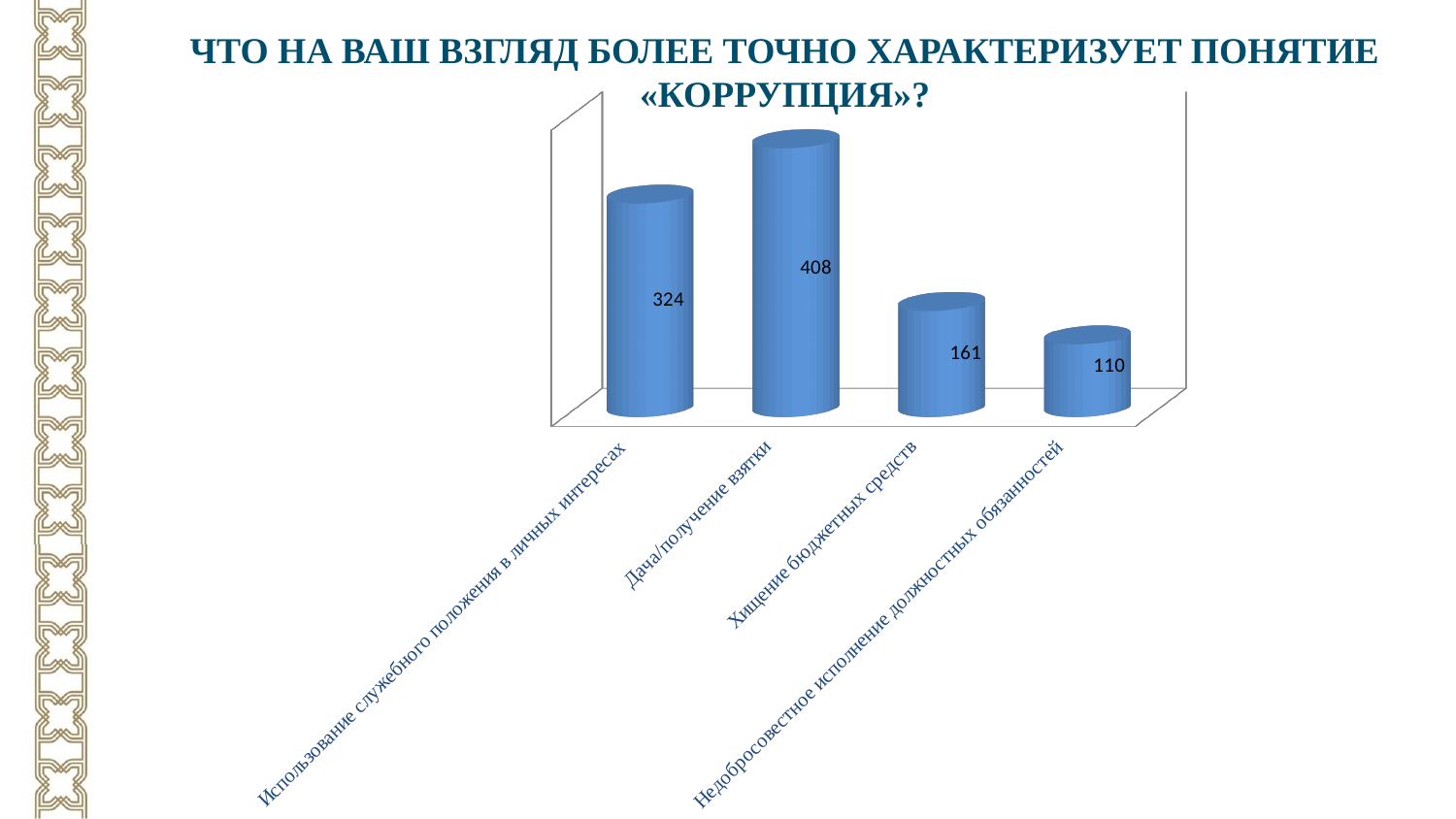
Which is larger: the value for «Использование служебного положения в личных интересах» or for «Хищение бюджетных средств»? Использование служебного положения в личных интересах What is the title of the chart? ЧТО НА ВАШ ВЗГЛЯД БОЛЕЕ ТОЧНО ХАРАКТЕРИЗУЕТ ПОНЯТИЕ «КОРРУПЦИЯ»? Which category has the highest value? Дача/получение взятки What is the value for «Недобросовестное исполнение должностных обязанностей»? 110 What is the value for «Использование служебного положения в личных интересах»? 324 What is the difference between the values for «Дача/получение взятки» and «Использование служебного положения в личных интересах»? 84 How many categories are shown in the chart? 4 Which category has the lowest value? Недобросовестное исполнение должностных обязанностей What is the difference between the values for «Хищение бюджетных средств» and «Недобросовестное исполнение должностных обязанностей»? 51 What is the value for «Хищение бюджетных средств»? 161 What kind of chart is shown on the slide? Bar chart What is the value for «Дача/получение взятки»? 408